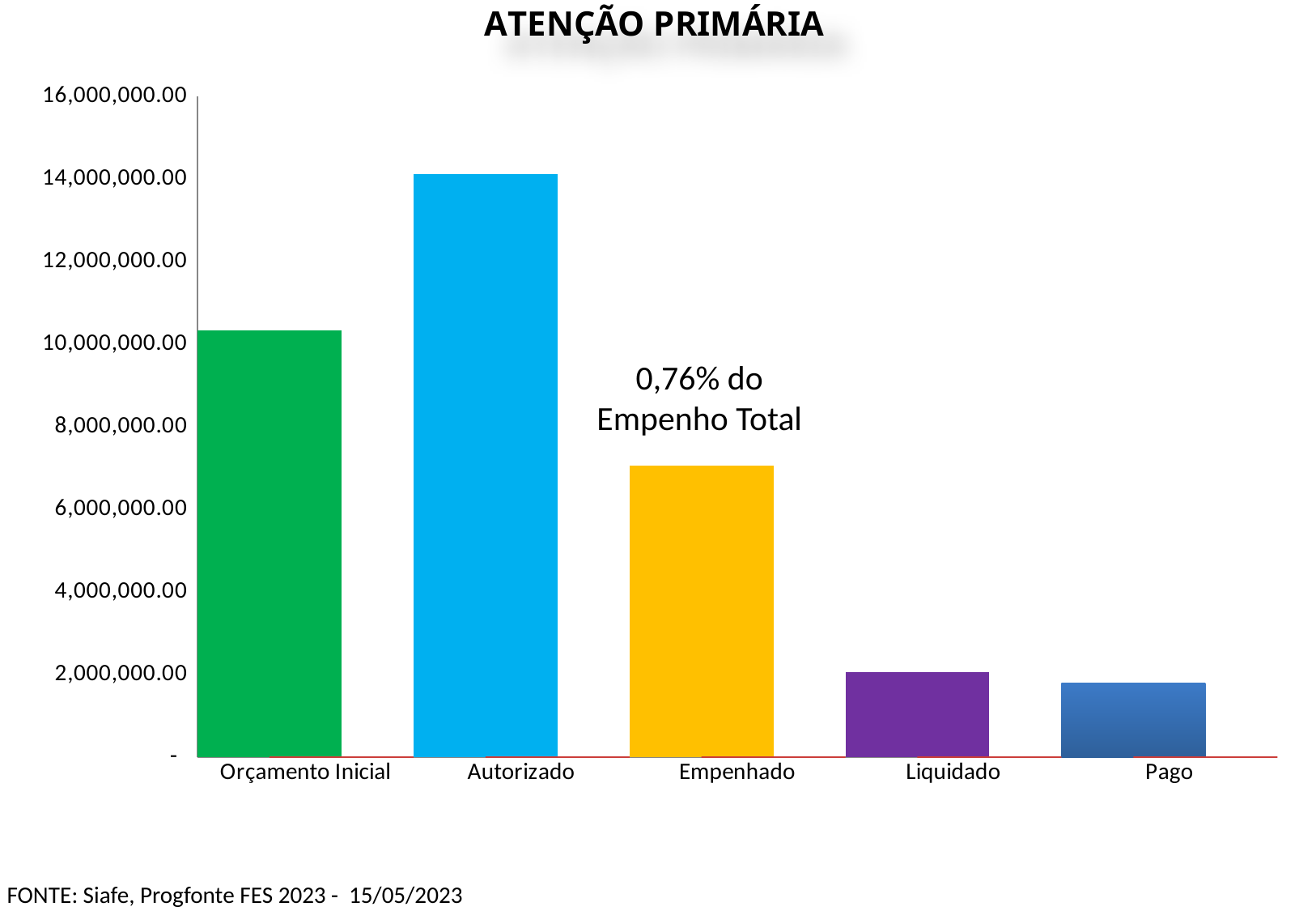
What is the title of the chart? ATENÇÃO PRIMÁRIA Is the value for Liquidado greater or less than 4,000,000.00? less Do the values rise or fall along the x axis from Autorizado to Pago? fall Which category has the highest value? Autorizado Which category has the lowest value? Pago Is the value for Empenhado greater or less than 8,000,000.00? less Is the value for Autorizado greater or less than 12,000,000.00? greater Which is larger, the value for Orçamento Inicial or the value for Empenhado? Orçamento Inicial What text annotation is printed above the Empenhado bar? 0,76% do Empenho Total How many categories are shown on the x axis of the chart? 5 What kind of chart is shown on the slide? bar chart